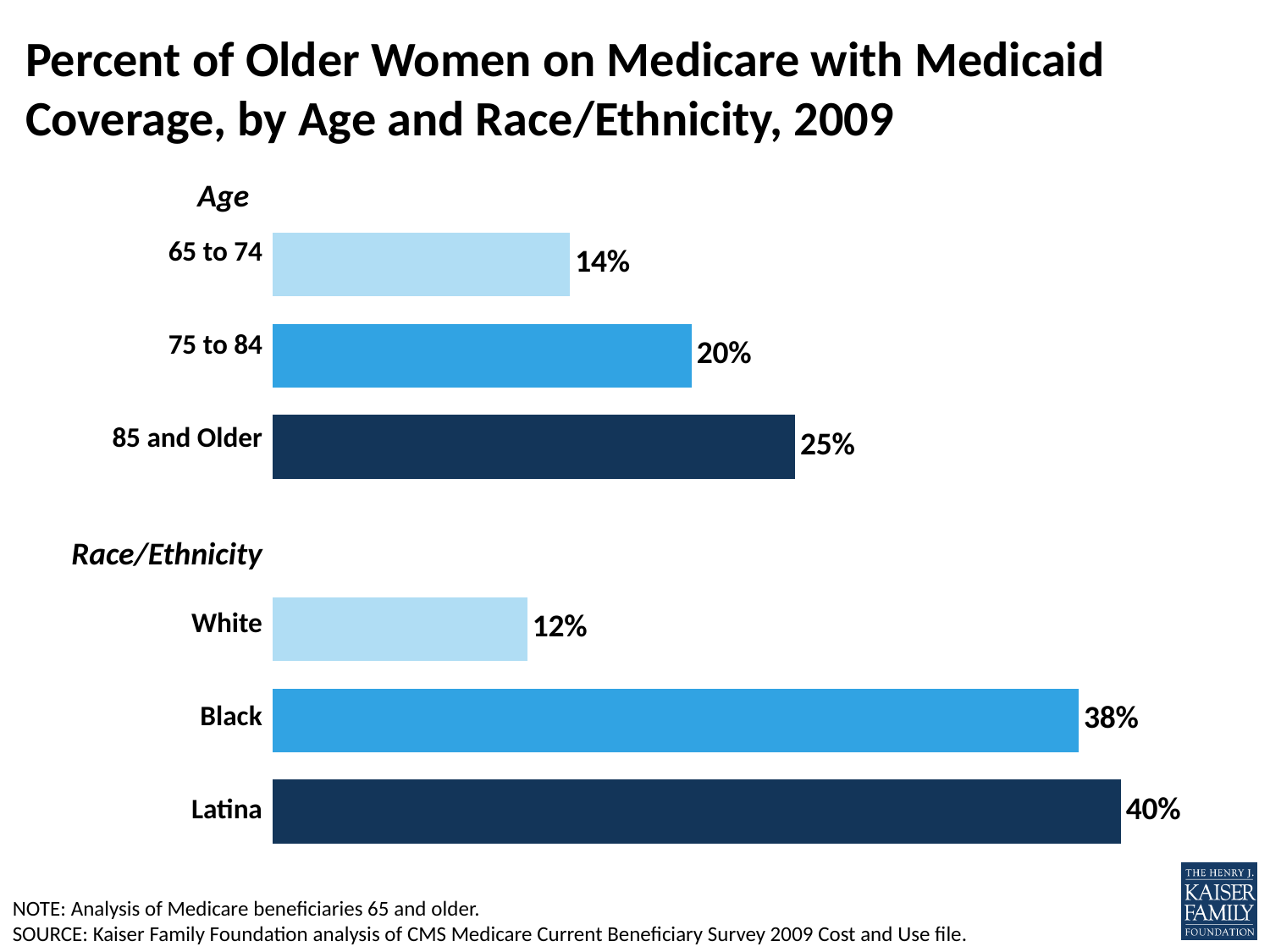
What is the difference in percentage points between Black and White women? 26 Do the values rise or fall as age increases from 65 to 74 to 85 and Older? Rise What is the difference in percentage points between the 85 and Older group and the 65 to 74 group? 11 What percent of Latina older women on Medicare have Medicaid coverage? 40% What is the value shown for White women? 12% Which age group has the highest percent with Medicaid coverage? 85 and Older Which race/ethnicity group has the lowest percent with Medicaid coverage? White Which is larger, the value for Black women or the value for Latina women? Latina What type of chart is used on this slide? Bar chart How many age groups are shown in the chart? 3 What percent of older women on Medicare aged 65 to 74 have Medicaid coverage? 14% What is the value shown for the 75 to 84 age group? 20%